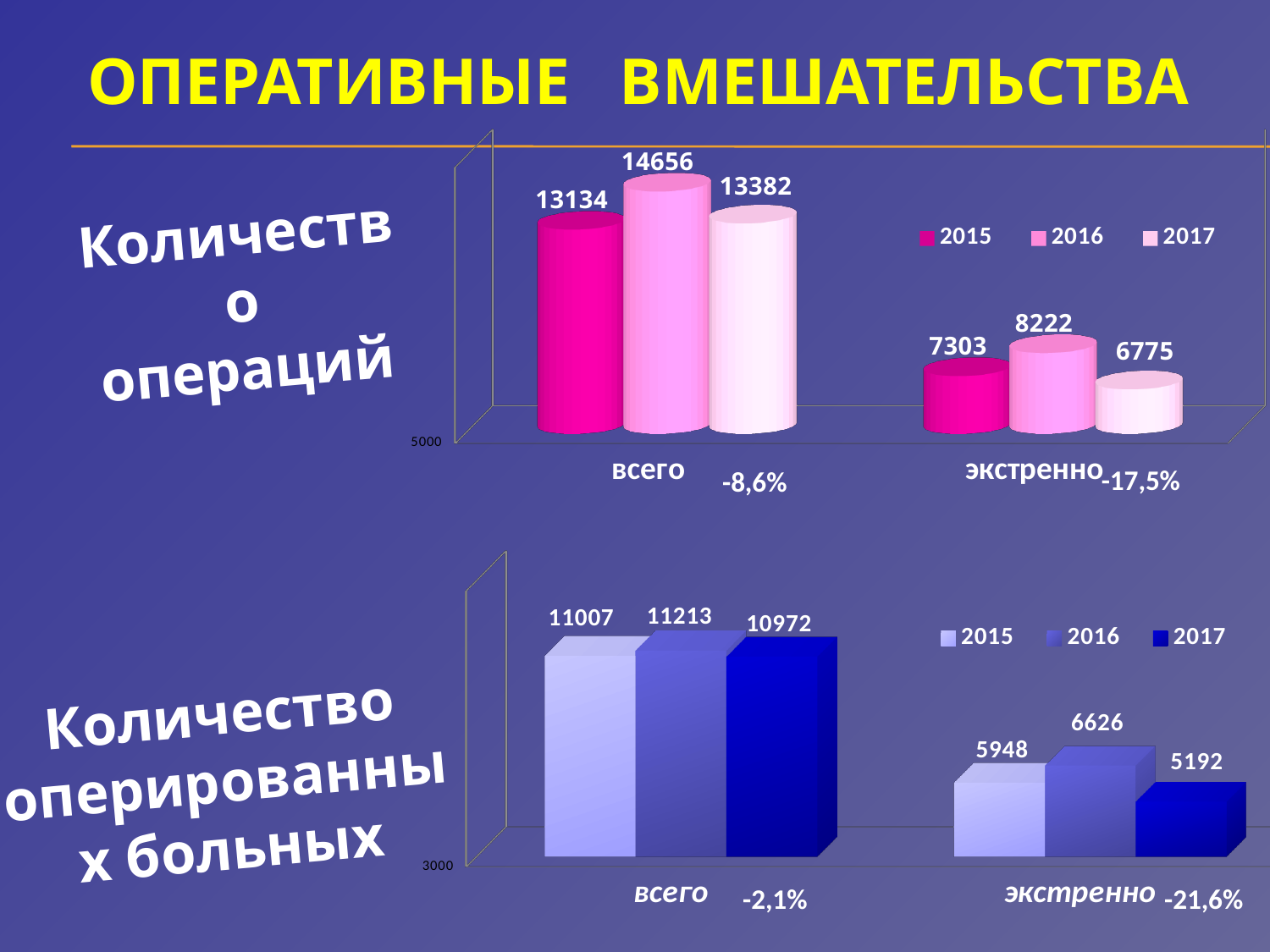
In the top chart (Количество операций), which year has the highest value in the 'всего' category? 2016 In the top chart (Количество операций), what is the value for 2016 in the 'всего' category? 14656 In the bottom chart (Количество оперированных больных), what is the difference between the 2016 and 2015 values in the 'всего' category? 206 In the bottom chart (Количество оперированных больных), what is the value for 2015 in the 'всего' category? 11007 In the top chart (Количество операций), which is larger in the 'всего' category: the 2015 value or the 2017 value? 2017 How many series does the legend of the bottom chart (Количество оперированных больных) list? 3 In the top chart (Количество операций), what is the difference between the 2016 and 2017 values in the 'экстренно' category? 1447 How many categories are shown on the x axis of the top chart (Количество операций)? 2 What kind of chart is the bottom chart (Количество оперированных больных)? Bar chart In the top chart (Количество операций), what is the value for 2017 in the 'экстренно' category? 6775 In the bottom chart (Количество оперированных больных), what is the value for 2016 in the 'экстренно' category? 6626 In the bottom chart (Количество оперированных больных), which year has the lowest value in the 'экстренно' category? 2017